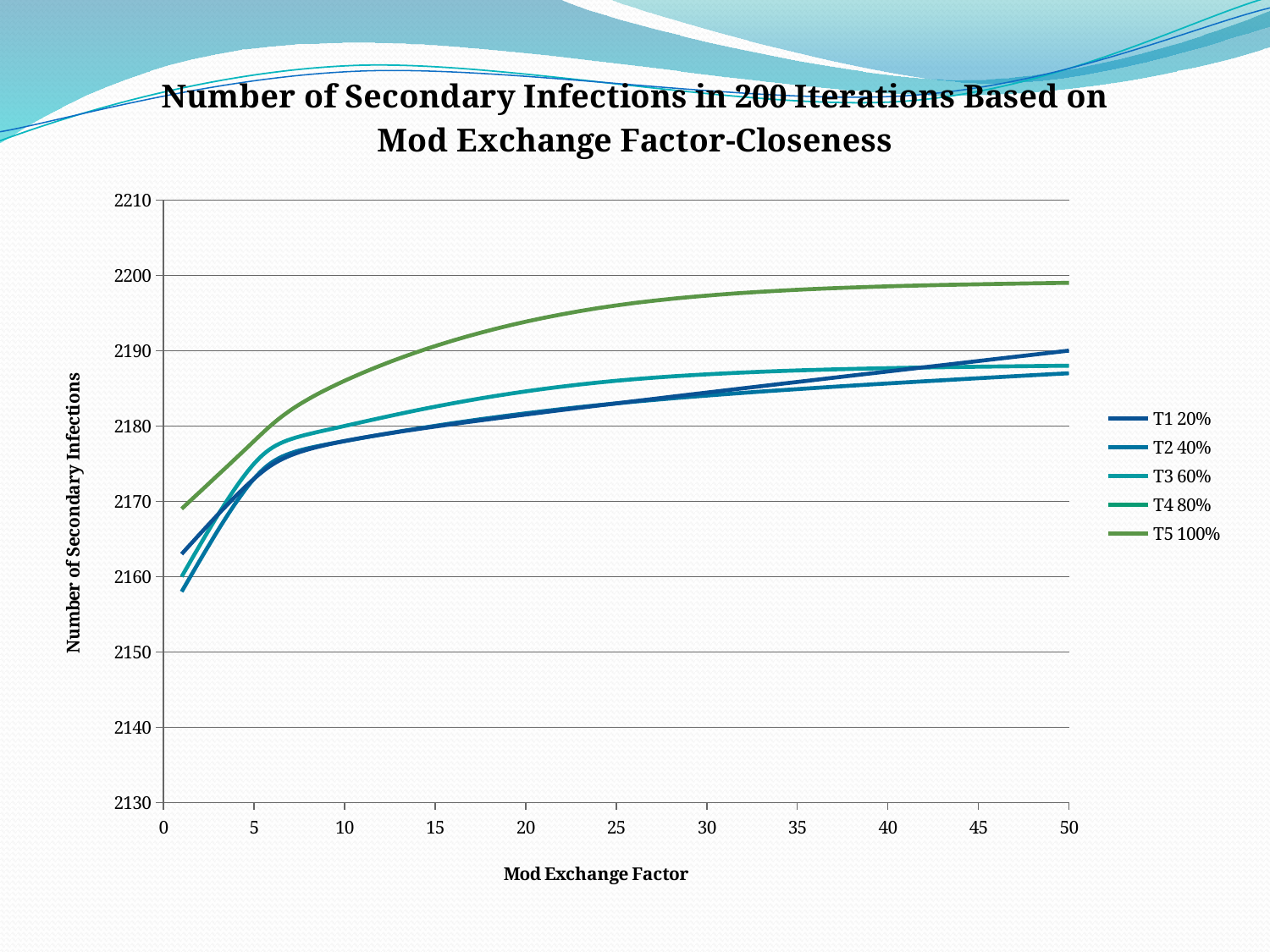
Is the value for T1 20% at a Mod Exchange Factor of 10 greater or less than 2180? less What is the label of the x axis? Mod Exchange Factor Is the value for T3 60% at a Mod Exchange Factor of 50 greater or less than 2190? less Is the value for T5 100% at a Mod Exchange Factor of 10 greater or less than 2180? greater What kind of chart is shown on the slide? Line chart What is the label of the y axis? Number of Secondary Infections Which series has the highest number of secondary infections at a Mod Exchange Factor of 50? T5 100% How many series does the legend list? 5 Do the values for the T1 20% series rise or fall as the Mod Exchange Factor increases? Rise Do the values for the T5 100% series rise or fall as the Mod Exchange Factor increases? Rise At a Mod Exchange Factor of 25, which series has the larger value, T5 100% or T1 20%? T5 100%